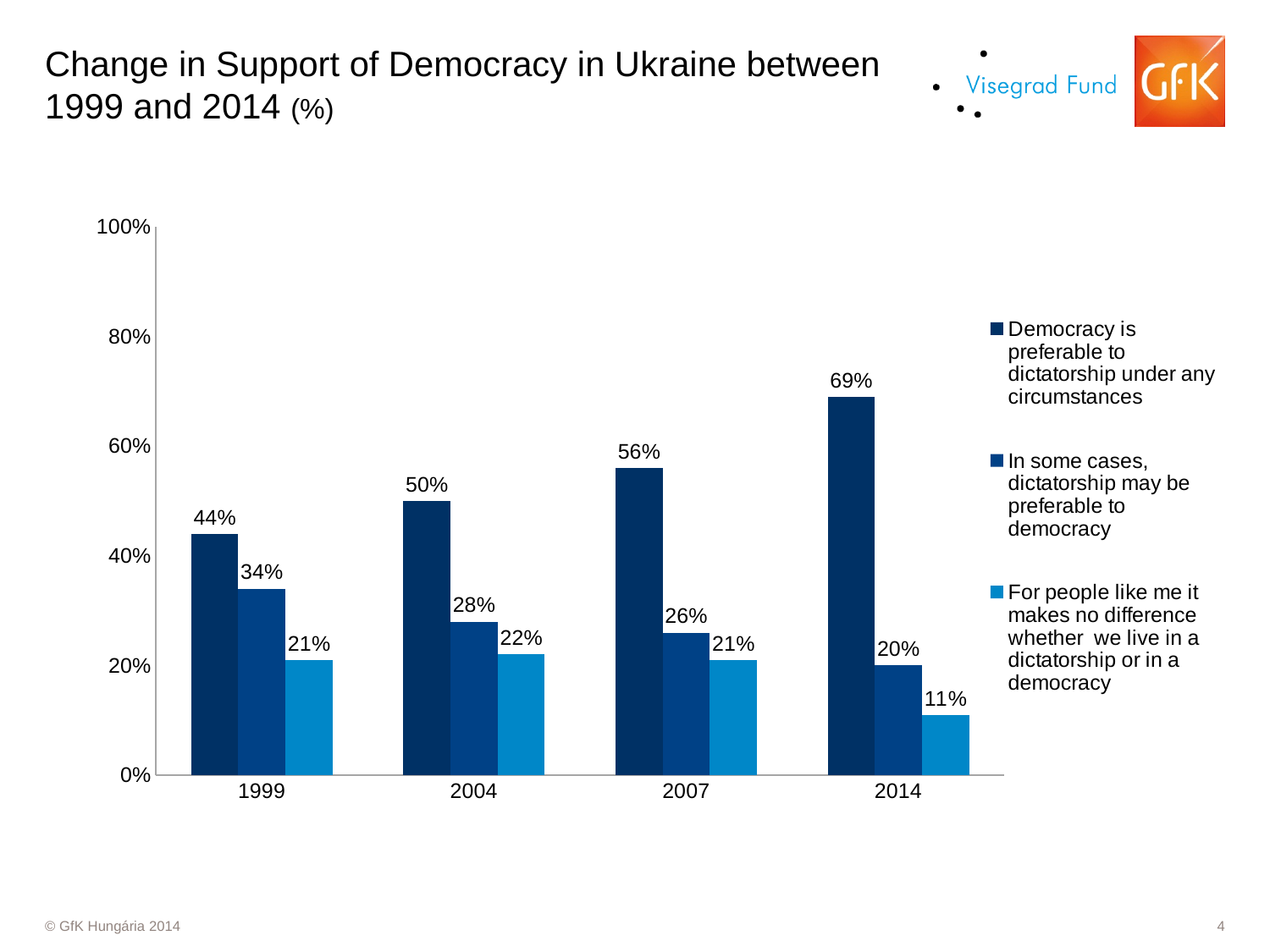
What is the difference between the 'in some cases dictatorship may be preferable' values in 1999 and 2014? 14 percentage points In which year was support for democracy under any circumstances highest? 2014 What type of chart is shown on the slide? Bar chart What percentage said it makes no difference whether they live in a dictatorship or a democracy in 2004? 22% What percentage said that in some cases dictatorship may be preferable to democracy in 1999? 34% How many years are shown on the x axis? 4 By how many percentage points did support for democracy under any circumstances increase between 1999 and 2014? 25 percentage points How does support for democracy under any circumstances change from 1999 to 2014? It rises Which was larger in 2007: the share saying dictatorship may be preferable in some cases, or the share saying it makes no difference? Dictatorship may be preferable in some cases (26%) In which year was the share saying it makes no difference lowest? 2014 How many series does the legend list? 3 What percentage said democracy is preferable to dictatorship under any circumstances in 2014? 69%